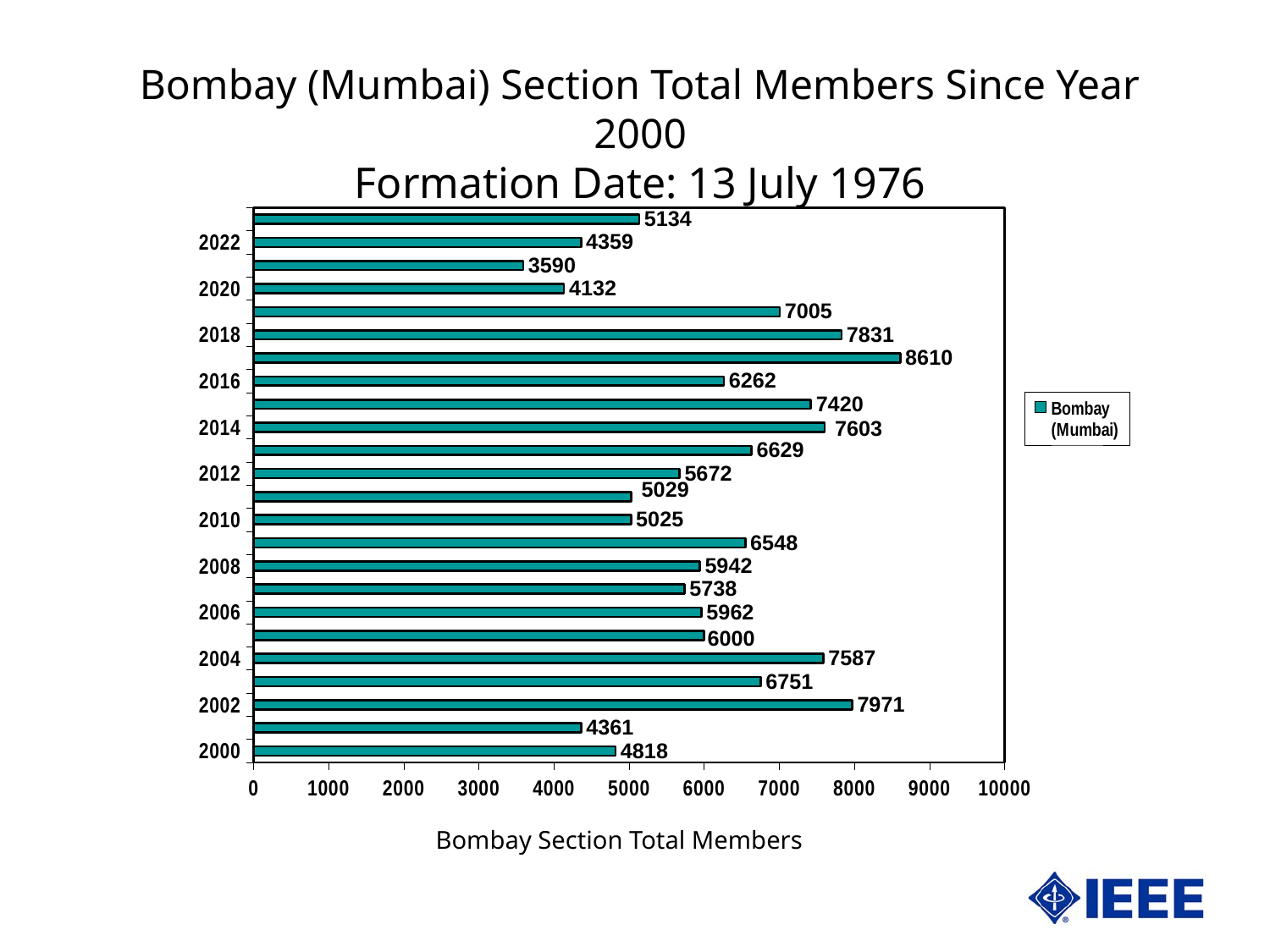
Which is larger, the value for 2018 or the value for 2016? 2018 How many series does the legend list? 1 How many bars are plotted on the chart? 24 What is the value for 2000? 4818 What is the lowest value shown on the chart? 3590 What is the value for 2022? 4359 Is the value for 2004 greater or less than 7000? greater What is the value for 2020? 4132 What is the value for 2014? 7603 What kind of chart is shown? bar chart What is the highest value shown on the chart? 8610 What is the difference between the values for 2002 and 2000? 3153